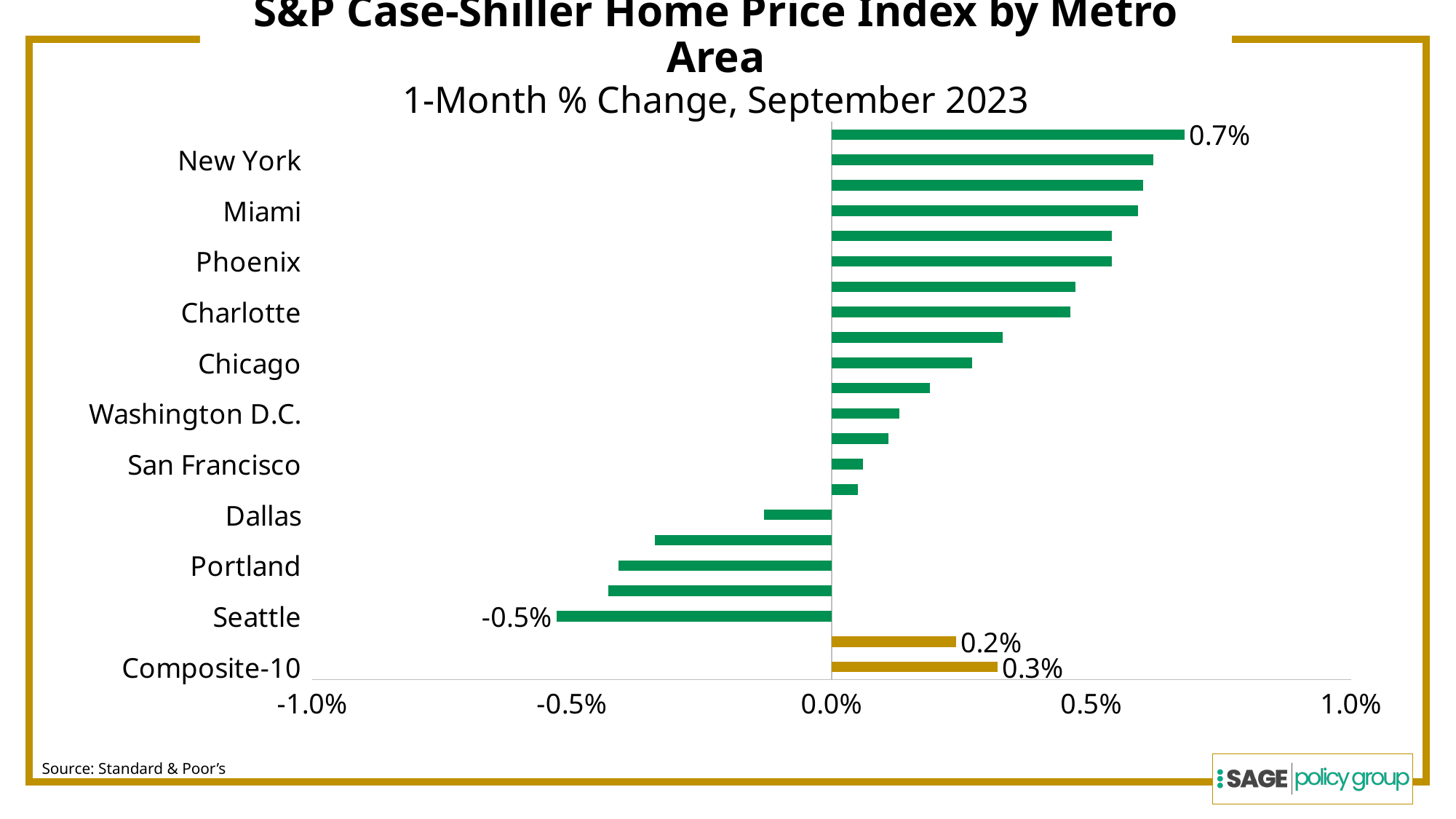
What is the 1-month % change for Composite-10? 0.3% Which has the larger 1-month % change, New York or Chicago? New York What is the difference between the Composite-10 value and the Seattle value? 0.8 percentage points What is the 1-month % change for Seattle? -0.5% What kind of chart is shown on the slide? bar chart Which labeled metro area has the lowest 1-month % change? Seattle Is the value for Washington D.C. greater or less than 0.5%? less How many category labels are listed on the vertical axis? 11 Is the value for Portland greater or less than 0.0%? less What is the source cited for the chart data? Standard & Poor's What is the largest value labeled on the chart? 0.7% Is the value for Miami greater or less than 0.5%? greater